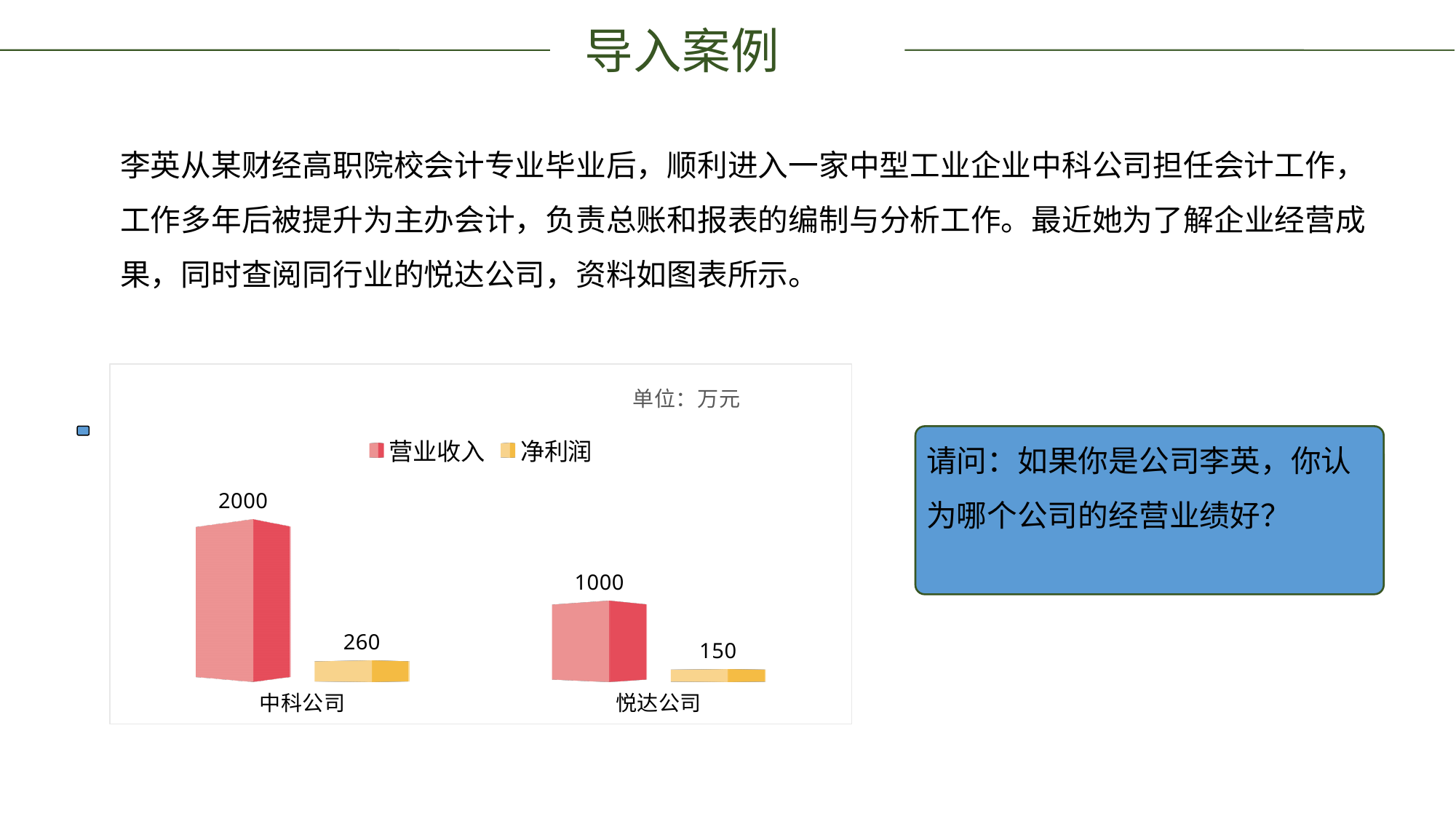
What is the difference in 营业收入 between 中科公司 and 悦达公司? 1000 What is the 营业收入 value for 中科公司? 2000 How many companies are shown on the x axis? 2 Is the 净利润 of 中科公司 larger or smaller than the 净利润 of 悦达公司? larger What is the 净利润 value for 中科公司? 260 Which company has the lower 净利润? 悦达公司 What is the difference in 净利润 between 中科公司 and 悦达公司? 110 What is the 营业收入 value for 悦达公司? 1000 What is the 净利润 value for 悦达公司? 150 Which company has the higher 营业收入? 中科公司 How many series does the legend list? 2 What kind of chart is shown? bar chart